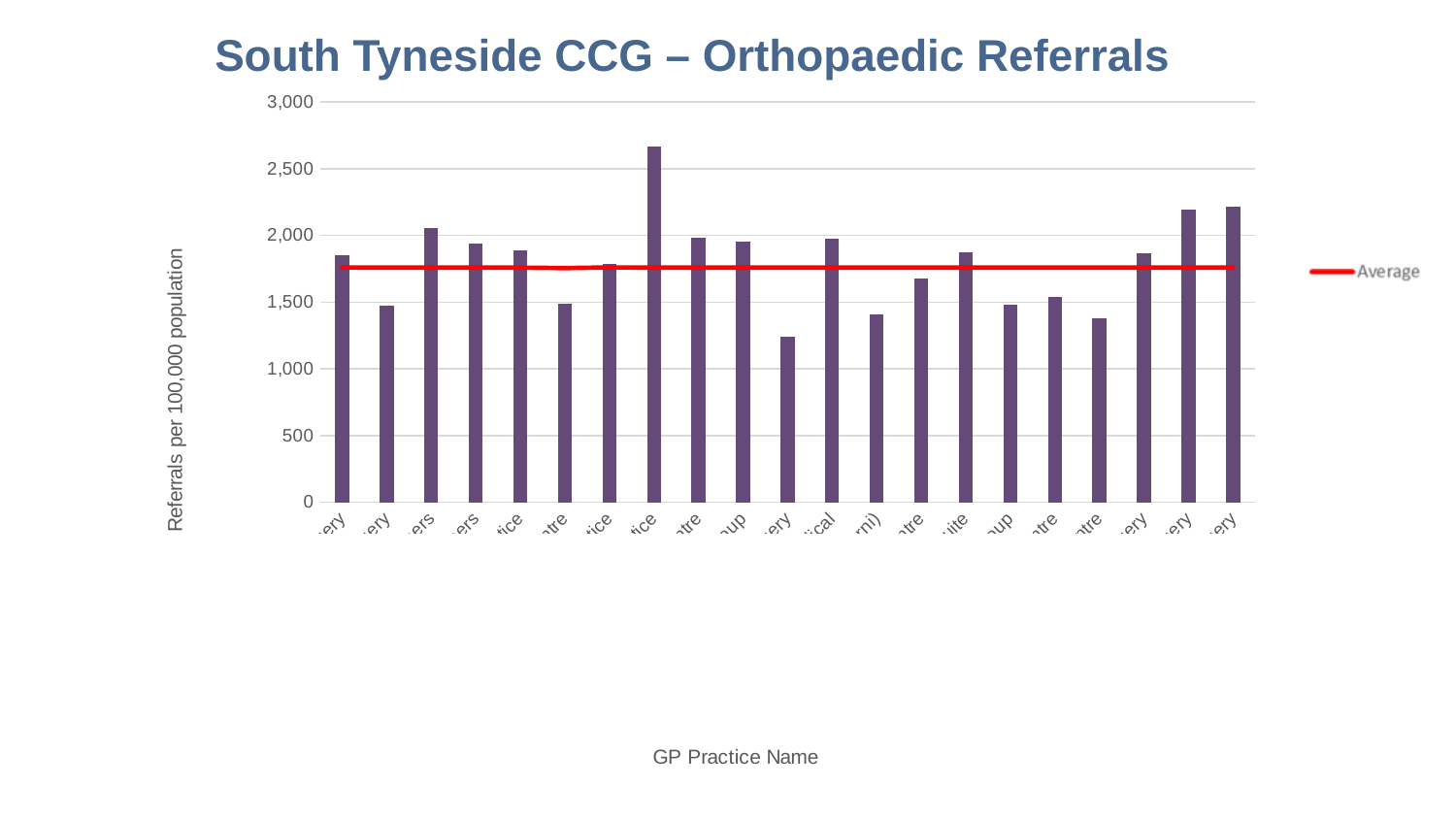
Is the value of the last bar on the right greater or less than 2,000? greater How many series does the legend list? 1 Is the value of the shortest bar greater or less than 1,500? less What kind of chart is shown on the slide? bar chart How many bars exceed 2,500 referrals per 100,000 population? 1 Is the Average line greater or less than 2,000? less What is the title of the chart? South Tyneside CCG – Orthopaedic Referrals How many bars (GP practices) are plotted in the chart? 21 What is the label on the vertical axis of the chart? Referrals per 100,000 population